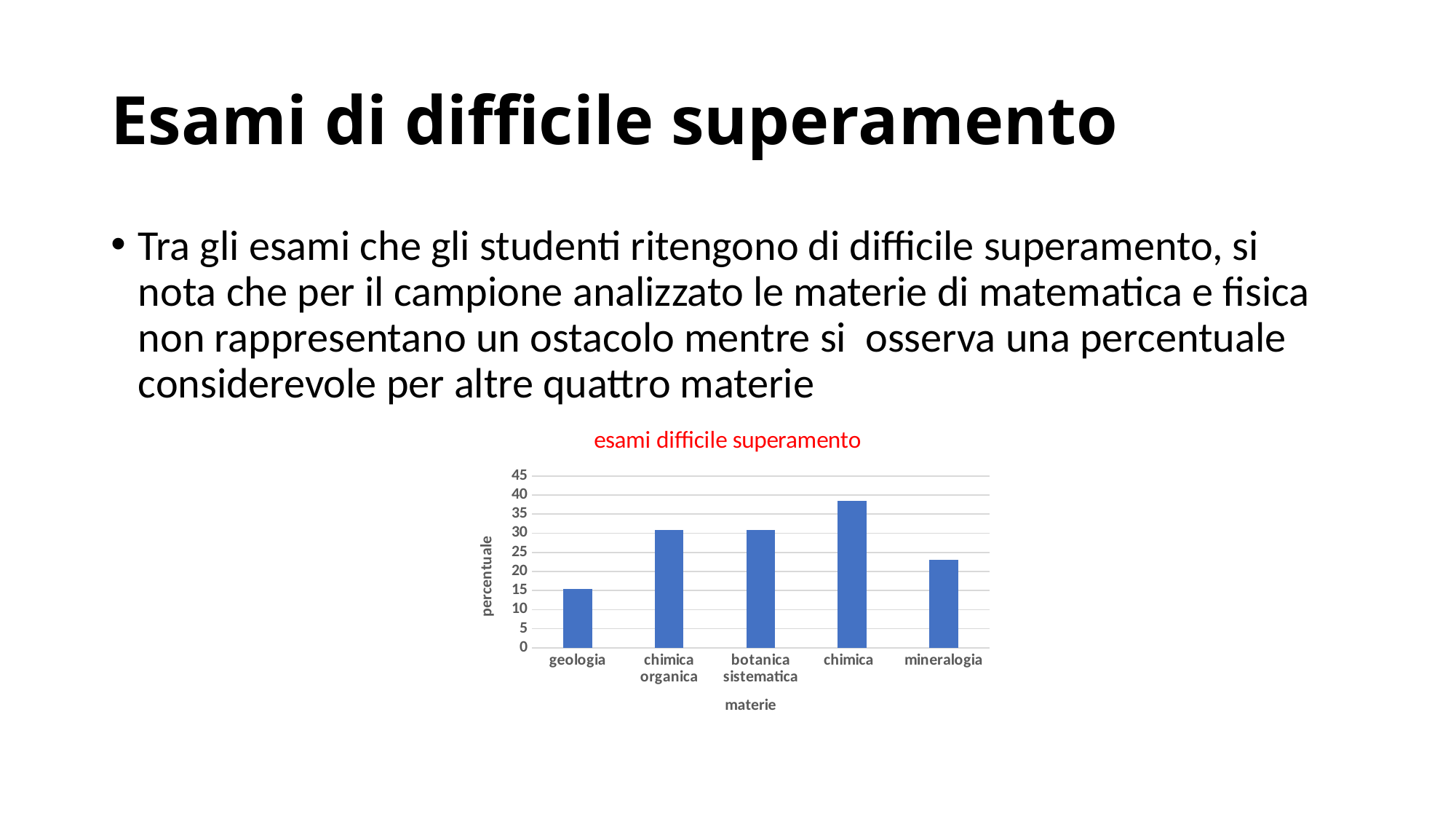
Is the value for chimica greater or less than 35? greater What is the label of the vertical axis of the chart? percentuale What kind of chart is shown on the slide? bar chart What is the title of the chart? esami difficile superamento Is the value for mineralogia greater or less than 20? greater How many subjects (categories) are plotted on the x axis of the chart? 5 Which is larger, the value for geologia or the value for botanica sistematica? botanica sistematica Is the value for geologia greater or less than 20? less Which is larger, the value for chimica or the value for mineralogia? chimica Which subject has the lowest bar in the chart? geologia Which subject has the highest bar in the chart? chimica